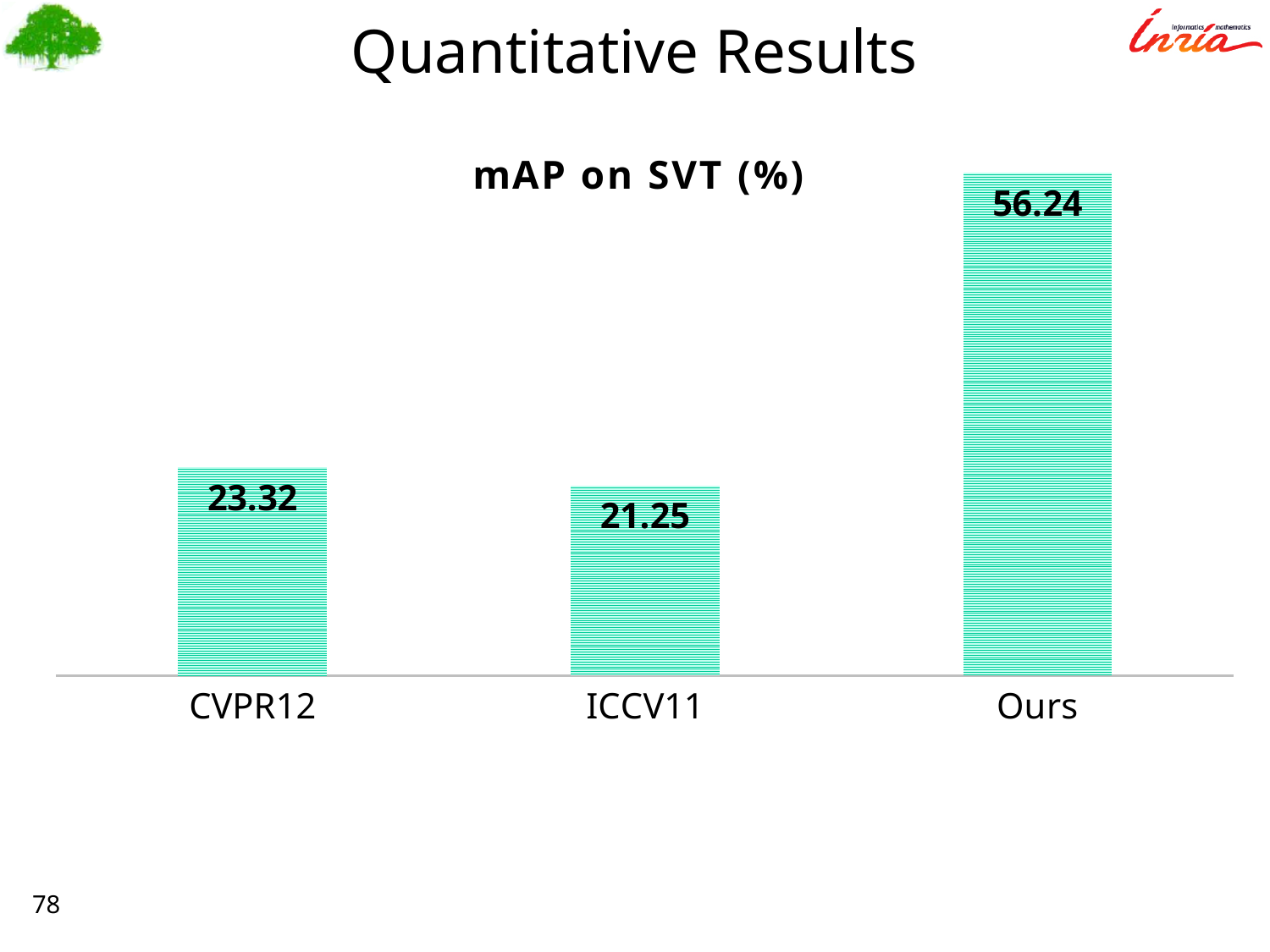
What is the mAP on SVT (%) for Ours? 56.24 Which method has the highest mAP on SVT? Ours What kind of chart is shown on the slide? Bar chart Which method has the lowest mAP on SVT? ICCV11 What is the title of the chart? mAP on SVT (%) Which has a higher mAP on SVT, ICCV11 or Ours? Ours How many methods are compared in the chart? 3 What is the mAP on SVT (%) for ICCV11? 21.25 What is the mAP on SVT (%) for CVPR12? 23.32 What is the difference in mAP on SVT between CVPR12 and ICCV11? 2.07 What is the difference in mAP on SVT between Ours and CVPR12? 32.92 Which has a higher mAP on SVT, CVPR12 or ICCV11? CVPR12